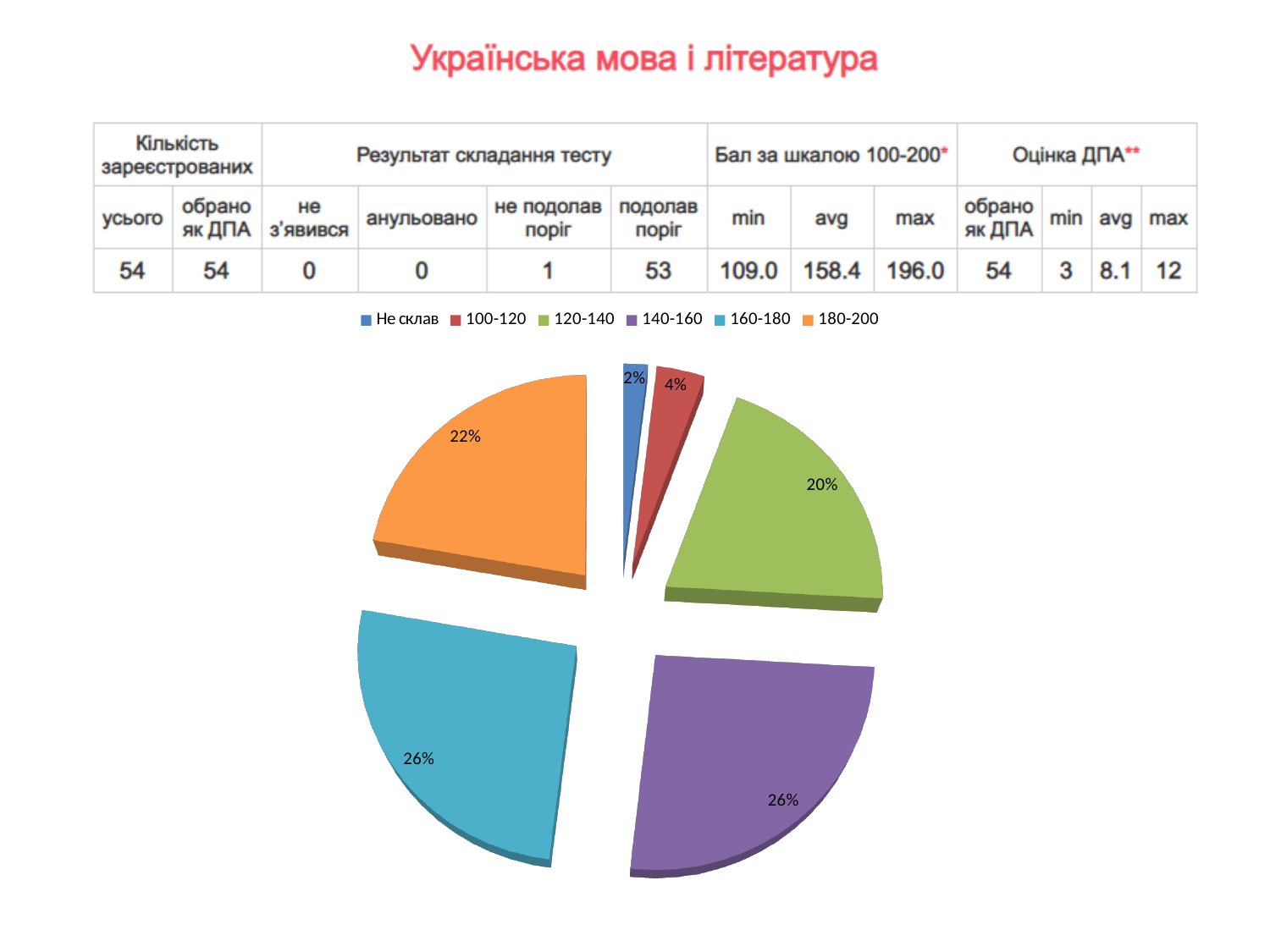
What share of the pie does the "100-120" slice represent? 4% What share of the pie does the "120-140" slice represent? 20% What share of the pie does the "180-200" slice represent? 22% How many entries does the legend list? 6 How many slices does the pie chart have? 6 Which category has the smallest slice of the pie? Не склав What kind of chart is shown on the slide? pie chart Which slice is larger, "120-140" or "180-200"? 180-200 What colour is the "180-200" slice in the pie chart? orange What is the difference in percentage points between the "140-160" slice and the "100-120" slice? 22